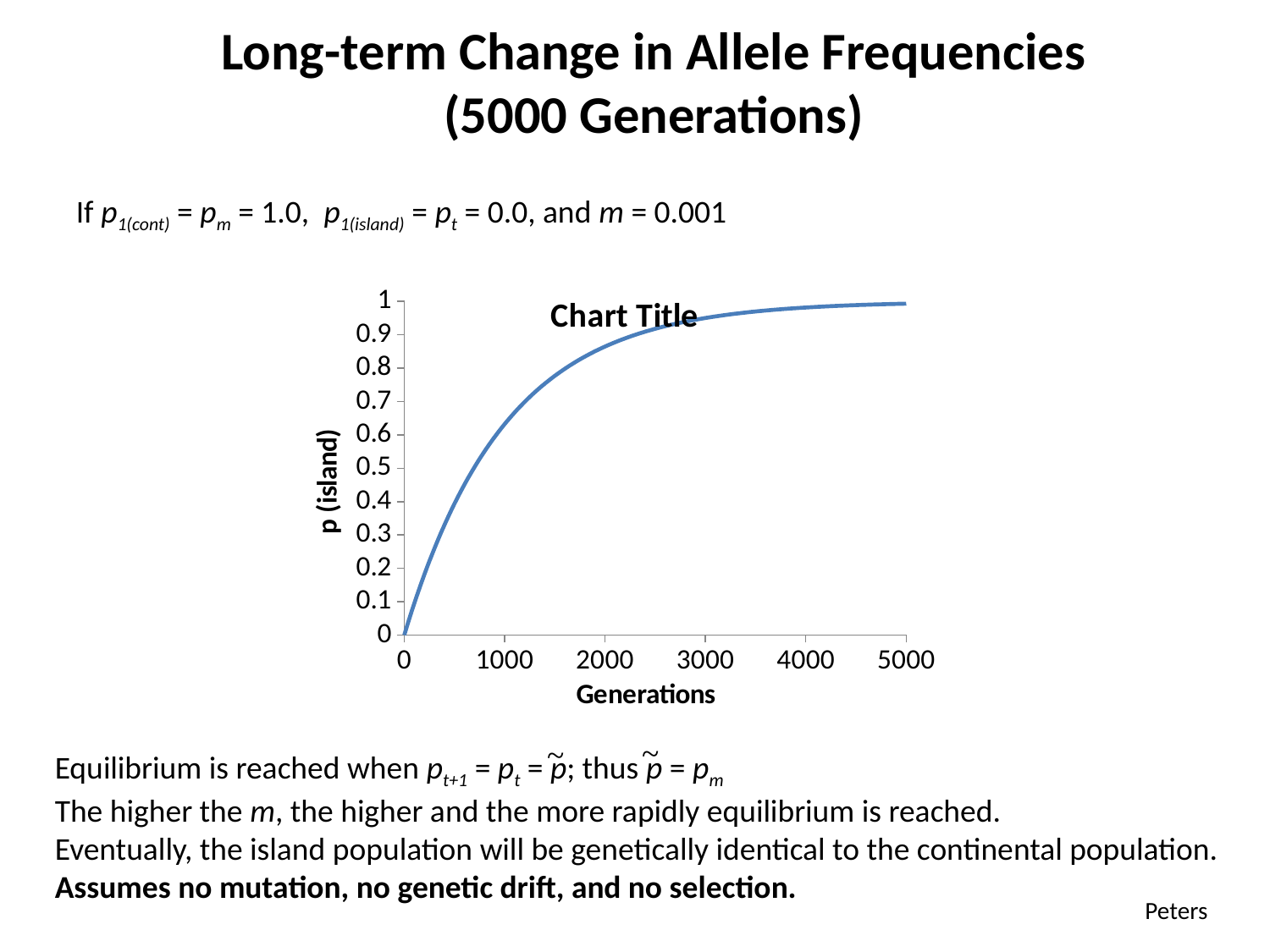
Is the value of p (island) at 1500 generations greater or less than 0.9? less Is the value of p (island) at 2000 generations greater or less than 0.7? greater Which is larger, the value of p (island) at 1000 generations or at 4000 generations? 4000 generations Is the value of p (island) at 1000 generations greater or less than 0.5? greater What is the label of the y axis of the chart? p (island) Does the value of p (island) rise or fall as Generations increase along the x axis? rise What kind of chart is shown on the slide? line chart What is the label of the x axis of the chart? Generations What is the value of p (island) at generation 0? 0